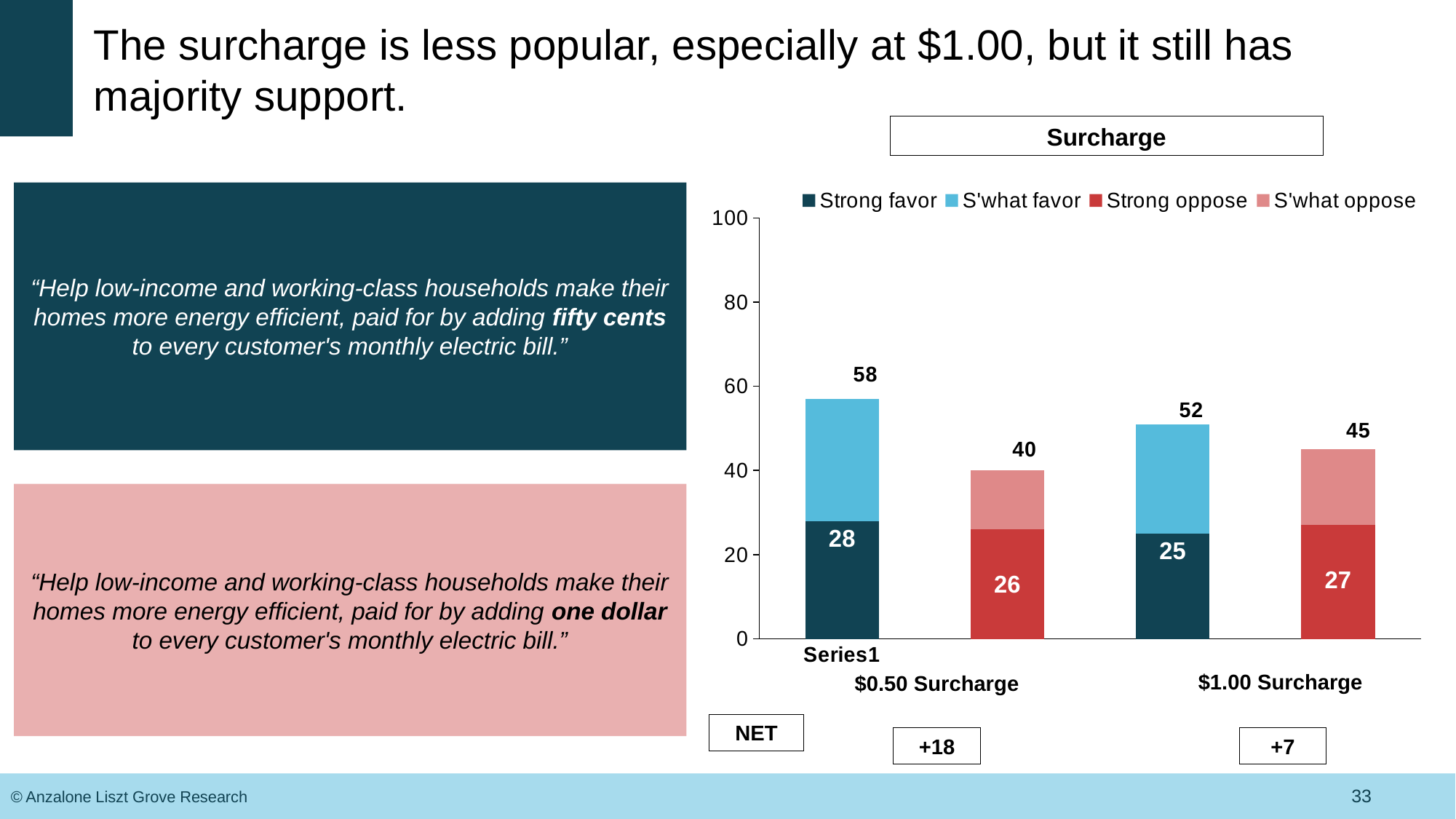
What is the total oppose shown above the oppose bar for the $0.50 Surcharge? 40 What kind of chart is shown on the slide? Stacked bar chart What is the Strong oppose value for the $1.00 Surcharge? 27 Which surcharge level has the higher total favor: $0.50 or $1.00? $0.50 Surcharge What is the NET value shown for the $1.00 Surcharge? +7 What is the title of the chart? Surcharge What is the total favor (Strong favor plus S'what favor) shown above the favor bar for the $1.00 Surcharge? 52 What is the difference between the Strong oppose values for the $1.00 Surcharge and the $0.50 Surcharge? 1 How many series does the legend list? 4 What is the Strong favor value for the $0.50 Surcharge? 28 What is the NET value shown for the $0.50 Surcharge? +18 What is the difference between the total favor for the $0.50 Surcharge and the total favor for the $1.00 Surcharge? 6